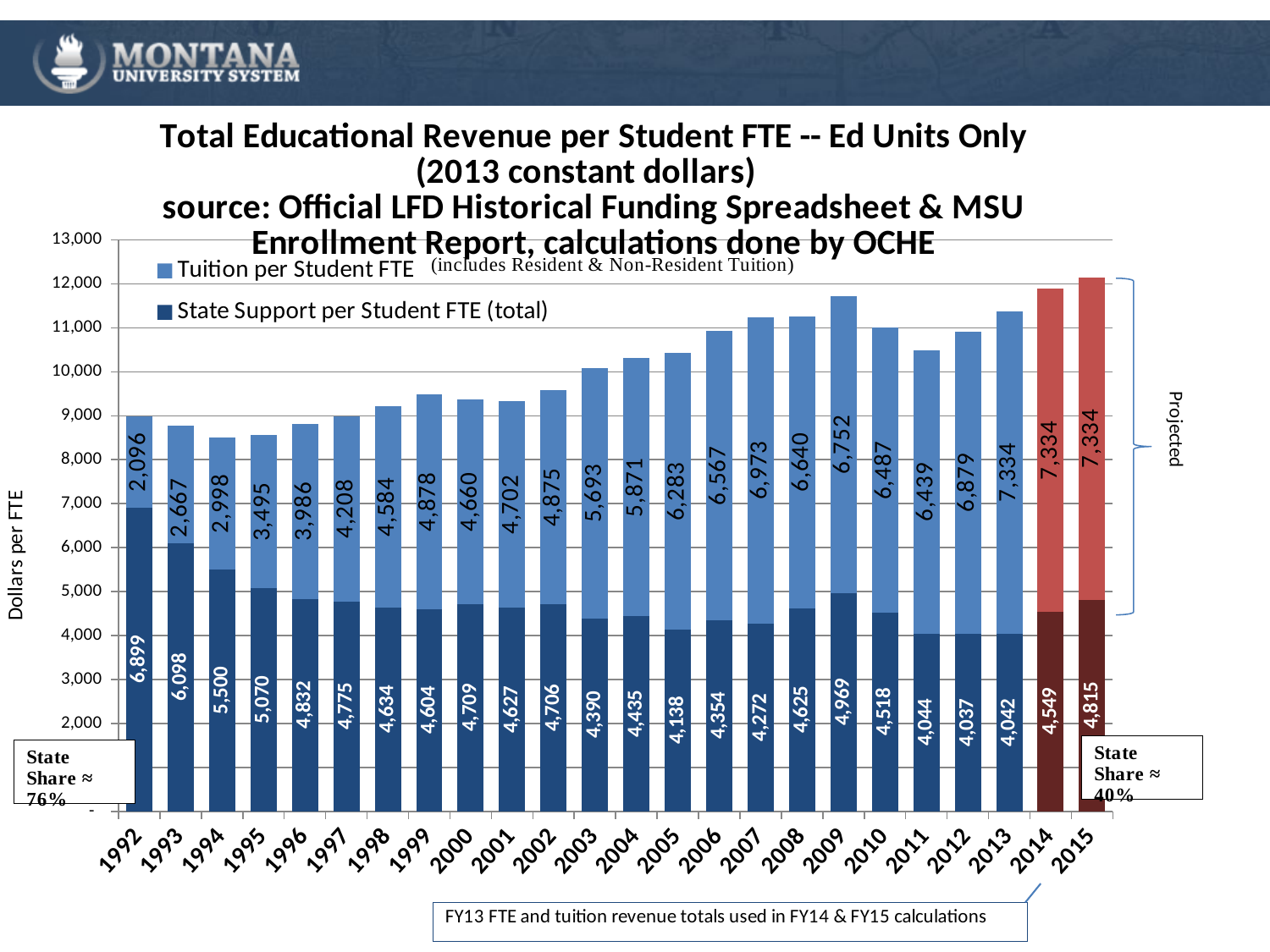
Which is larger, State Support per Student FTE in 2009 or in 2010? 2009 What is the difference between State Support per Student FTE in 2015 and in 2014? 266 Is the total revenue per student FTE for 2009 greater or less than 11,000? greater Which year has the lowest Tuition per Student FTE? 1992 Which year has the highest State Support per Student FTE (total)? 1992 What is the Tuition per Student FTE value for 1992? 2,096 What kind of chart is shown on the slide? Stacked bar chart What is the total of the stacked bar for 1992? 8,995 How many years are shown on the x axis? 24 What is the State Support per Student FTE (total) value for 2009? 4,969 Does Tuition per Student FTE generally rise or fall from 1992 to 2015? Rise How many series does the legend list? 2